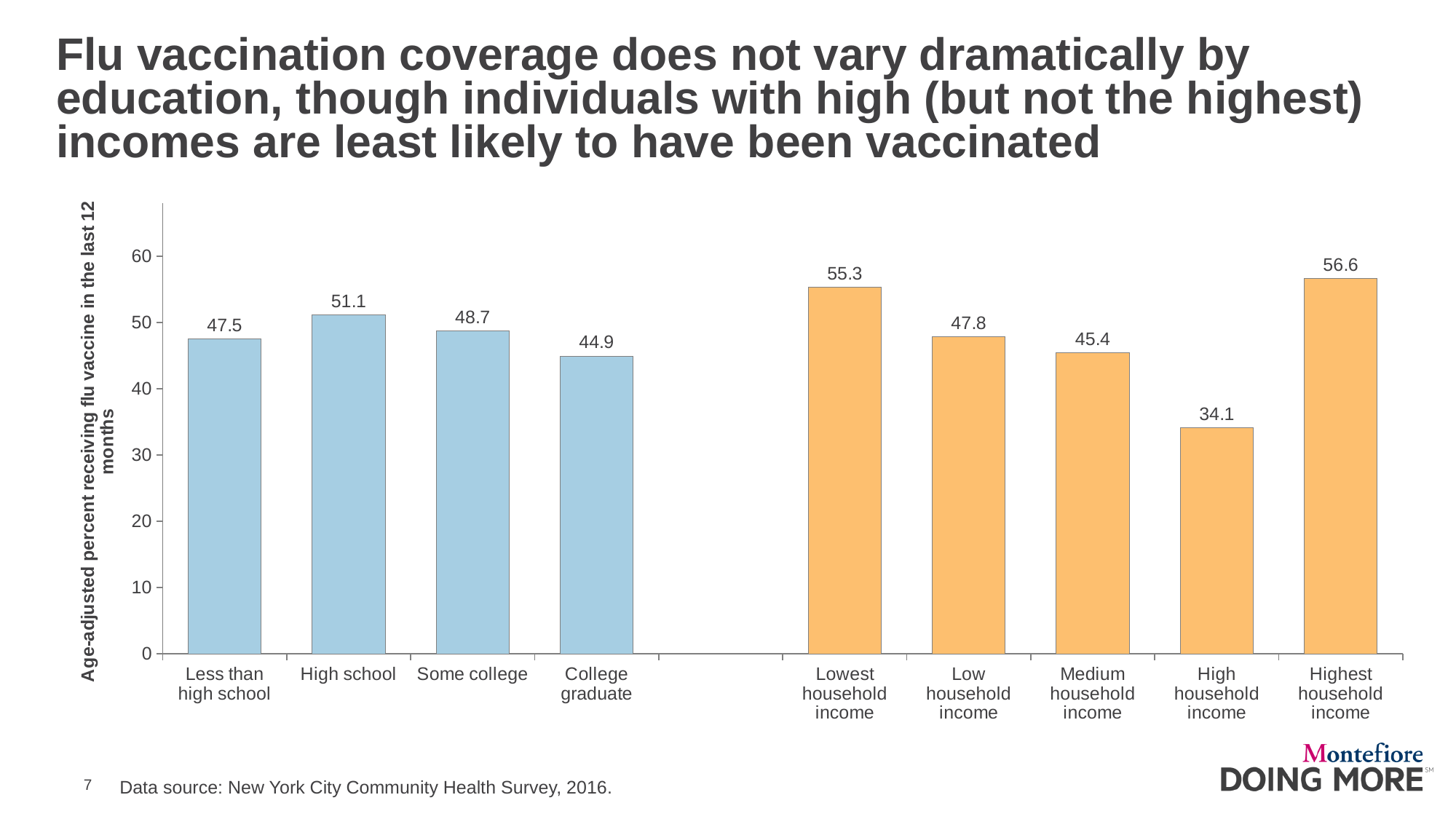
What kind of chart is shown on the slide? bar chart Which category has the highest value on the chart? Highest household income What is the value for College graduate? 44.9 What is the difference between the values for High school and Less than high school? 3.6 Which category has the lowest value on the chart? High household income What is the value for High household income? 34.1 What is the label of the vertical axis? Age-adjusted percent receiving flu vaccine in the last 12 months How many categories are shown on the chart? 9 What is the difference between the values for Highest household income and High household income? 22.5 What is the age-adjusted percent receiving flu vaccine for the High school category? 51.1 Is the value for Medium household income greater or less than 50? less Which is larger, the value for Lowest household income or Low household income? Lowest household income